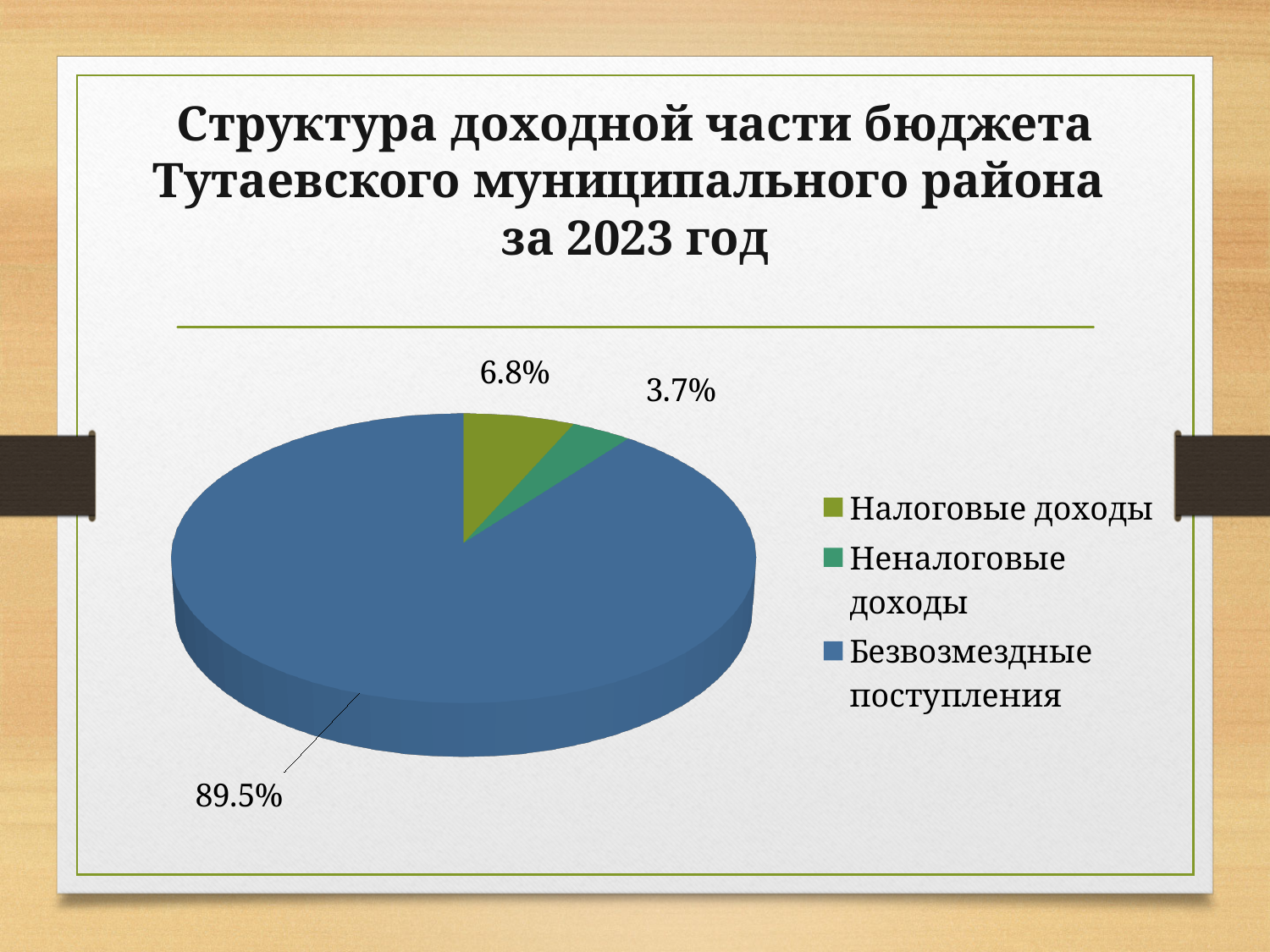
What share of the budget revenue is Неналоговые доходы? 3.7% How many categories does the pie chart show? 3 Which category has the smallest share of the pie? Неналоговые доходы Which is larger, the share for Налоговые доходы or the share for Неналоговые доходы? Налоговые доходы What colour is the slice for Безвозмездные поступления? blue What is the difference in percentage points between Безвозмездные поступления and Налоговые доходы? 82.7 What kind of chart is shown on the slide? pie chart Which year does the chart title refer to? 2023 What share of the budget revenue is Налоговые доходы? 6.8% What is the difference in percentage points between Налоговые доходы and Неналоговые доходы? 3.1 What share of the budget revenue is Безвозмездные поступления? 89.5% Which category has the largest share of the pie? Безвозмездные поступления